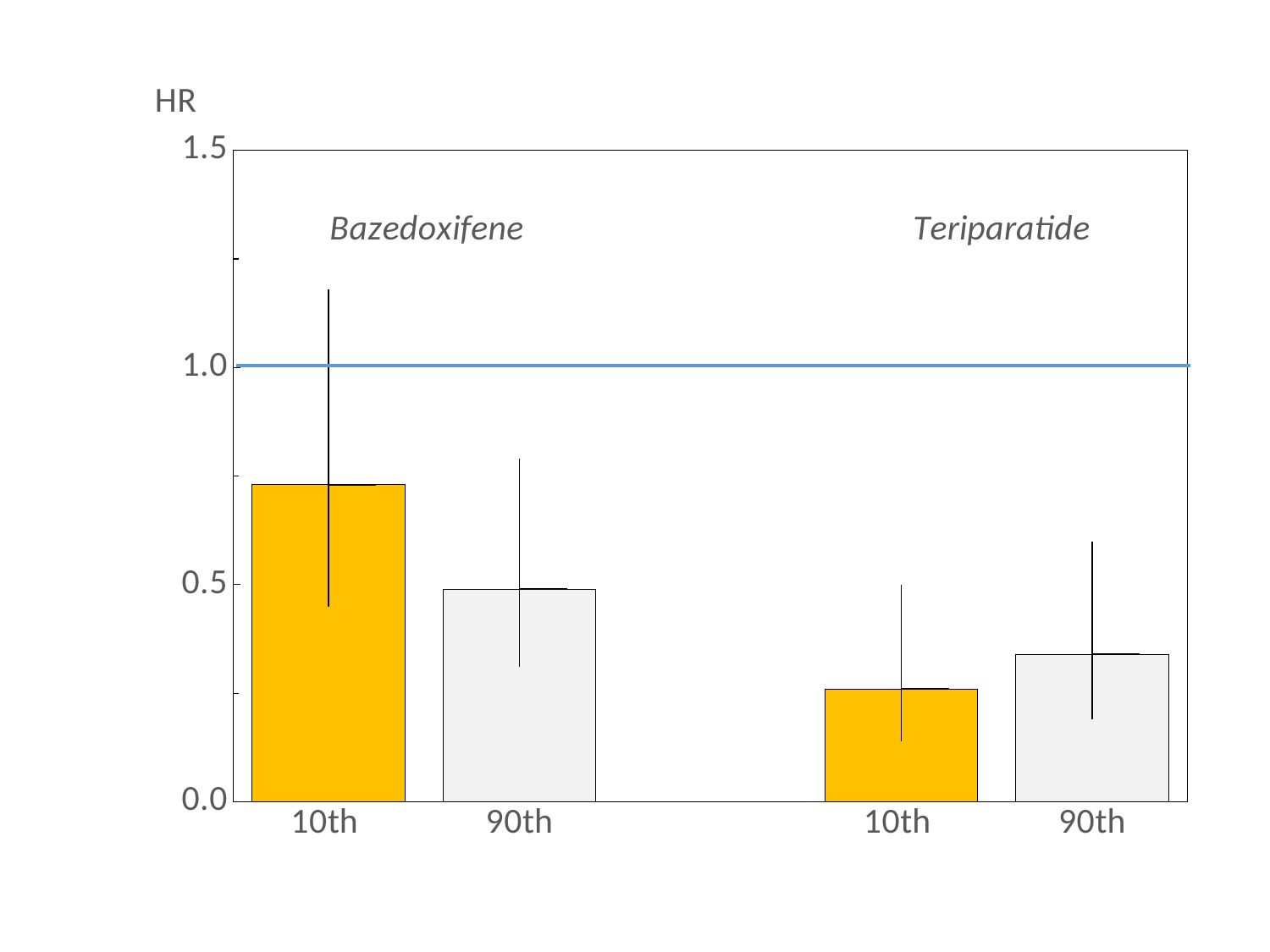
Is the HR value for the Bazedoxifene 10th bar greater or less than 1.0? less Is the HR value for the Teriparatide 90th bar greater or less than 0.5? less What kind of chart is shown on the slide? bar chart Is the HR value for the Teriparatide 10th bar greater or less than 0.5? less What label is shown on the y axis of the chart? HR Which bar has the lowest HR value? Teriparatide 10th For Bazedoxifene, which bar is larger, 10th or 90th? 10th For Teriparatide, which bar is larger, 10th or 90th? 90th At what HR value is the horizontal blue reference line drawn? 1.0 How many bars are plotted in the chart? 4 Which bar has the highest HR value? Bazedoxifene 10th